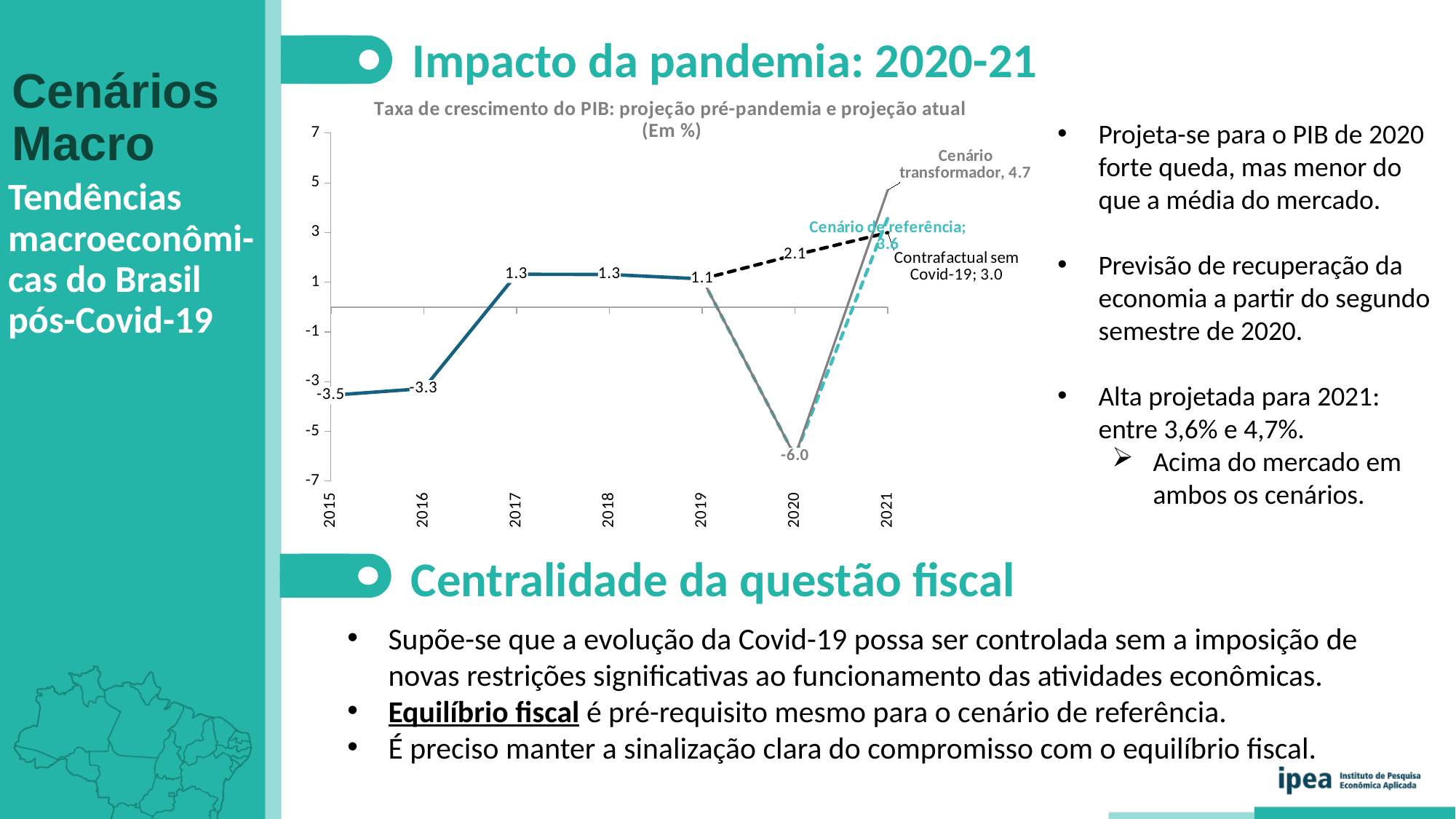
What is the 2021 value for the 'Cenário transformador' scenario? 4.7 Which year has the lowest GDP growth value on the chart? 2020 What is the difference between the 'Cenário transformador' value (4.7) and the 'Cenário de referência' value (3.6) for 2021? 1.1 What is the title of the chart? Taxa de crescimento do PIB: projeção pré-pandemia e projeção atual (Em %) What is the projected GDP growth rate for 2020 in the current projection (the lowest point on the chart)? -6.0 What is the GDP growth rate value shown for 2019? 1.1 What is the GDP growth rate value shown for 2015? -3.5 What is the GDP growth rate value shown for 2016? -3.3 What is the 2021 value for the 'Contrafactual sem Covid-19' scenario? 3.0 What type of chart is shown on the slide? line chart Which is larger: the 2017 value or the 2019 value? 2017 What is the 2021 value for the 'Cenário de referência' scenario? 3.6